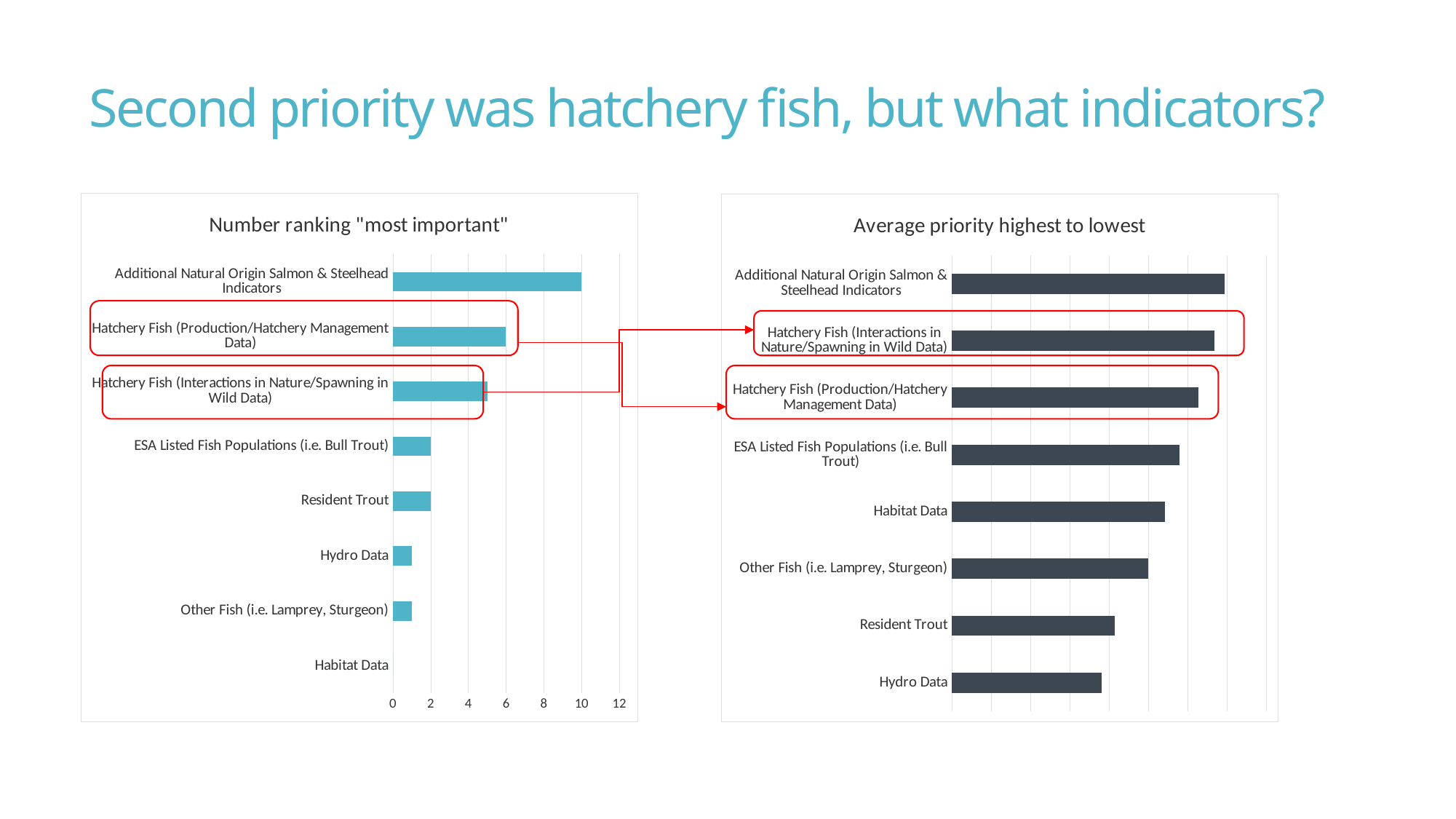
In the left chart (Number ranking "most important"), is the value for Hydro Data greater or less than 2? less In the left chart (Number ranking "most important"), which is larger, the value for ESA Listed Fish Populations (i.e. Bull Trout) or the value for Hydro Data? ESA Listed Fish Populations (i.e. Bull Trout) In the left chart (Number ranking "most important"), what is the value for Additional Natural Origin Salmon & Steelhead Indicators? 10 In the right chart (Average priority highest to lowest), which is larger, the value for Habitat Data or the value for Resident Trout? Habitat Data In the right chart (Average priority highest to lowest), which category has the lowest value? Hydro Data In the right chart (Average priority highest to lowest), which category has the highest value? Additional Natural Origin Salmon & Steelhead Indicators What kind of chart is the left chart titled "Number ranking "most important""? bar chart In the left chart (Number ranking "most important"), what is the difference between the values for Additional Natural Origin Salmon & Steelhead Indicators and Hatchery Fish (Production/Hatchery Management Data)? 4 In the left chart (Number ranking "most important"), what is the value for Hatchery Fish (Production/Hatchery Management Data)? 6 In the left chart (Number ranking "most important"), which category has the highest value? Additional Natural Origin Salmon & Steelhead Indicators How many categories are shown in the left chart (Number ranking "most important")? 8 In the left chart (Number ranking "most important"), is the value for Hatchery Fish (Interactions in Nature/Spawning in Wild Data) greater or less than 4? greater